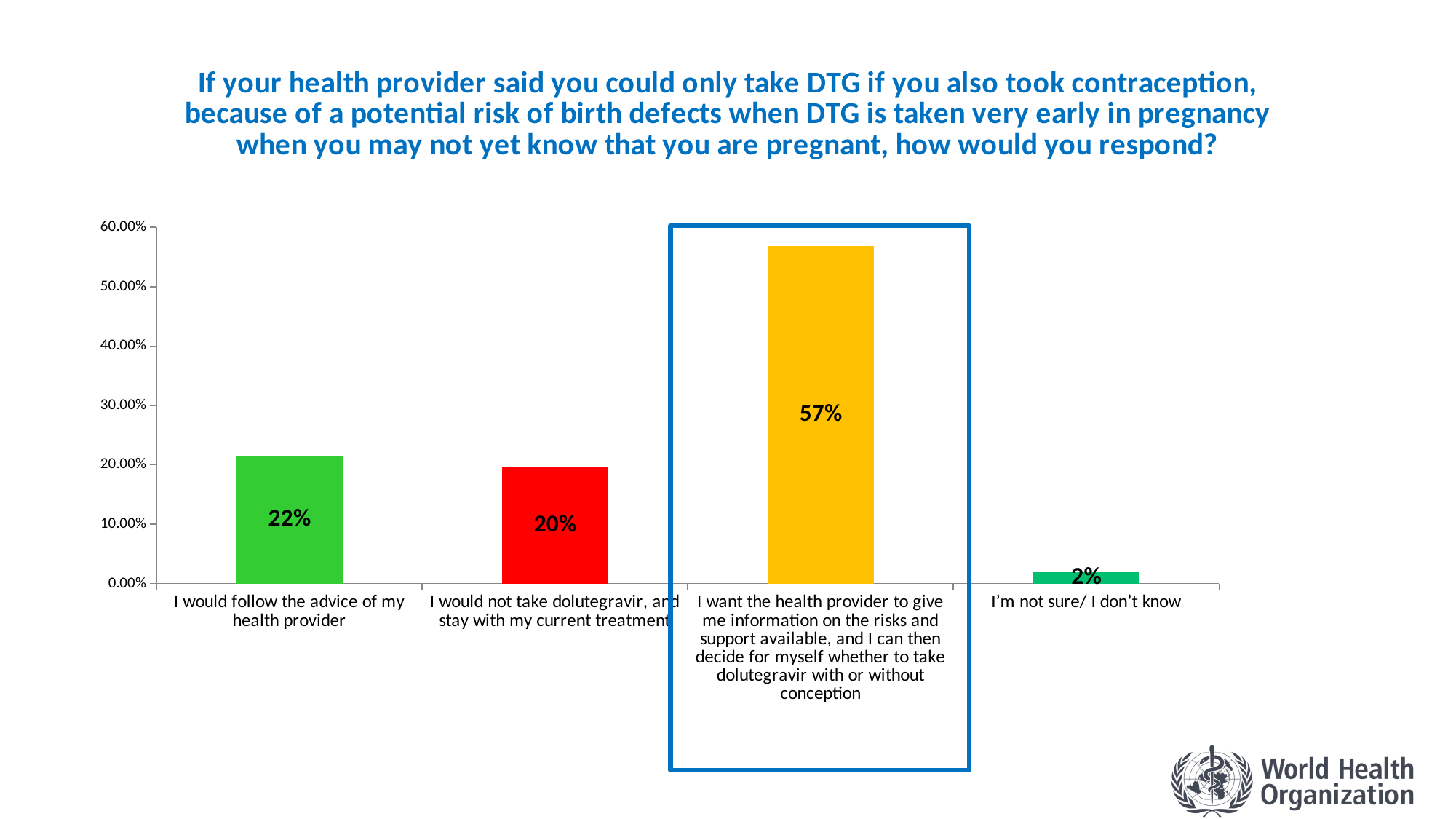
What percentage of respondents said they would not take dolutegravir and stay with their current treatment? 20% What percentage of respondents said they would follow the advice of their health provider? 22% What type of chart is shown on the slide? Bar chart Which is larger: the percentage for 'I would follow the advice of my health provider' or for 'I'm not sure/ I don't know'? I would follow the advice of my health provider How many response categories are shown in the chart? 4 What is the difference in percentage points between 'I would follow the advice of my health provider' and 'I would not take dolutegravir, and stay with my current treatment'? 2 percentage points Which response option has the highest percentage? I want the health provider to give me information on the risks and support available, and I can then decide for myself whether to take dolutegravir with or without conception What percentage of respondents answered 'I'm not sure/ I don't know'? 2% Which response option has the lowest percentage? I'm not sure/ I don't know Is the value for the 'I want the health provider to give me information...' bar greater or less than 50.00%? greater What colour is the bar for 'I would not take dolutegravir, and stay with my current treatment'? Red What percentage of respondents want the health provider to give them information on the risks and support available so they can decide for themselves? 57%